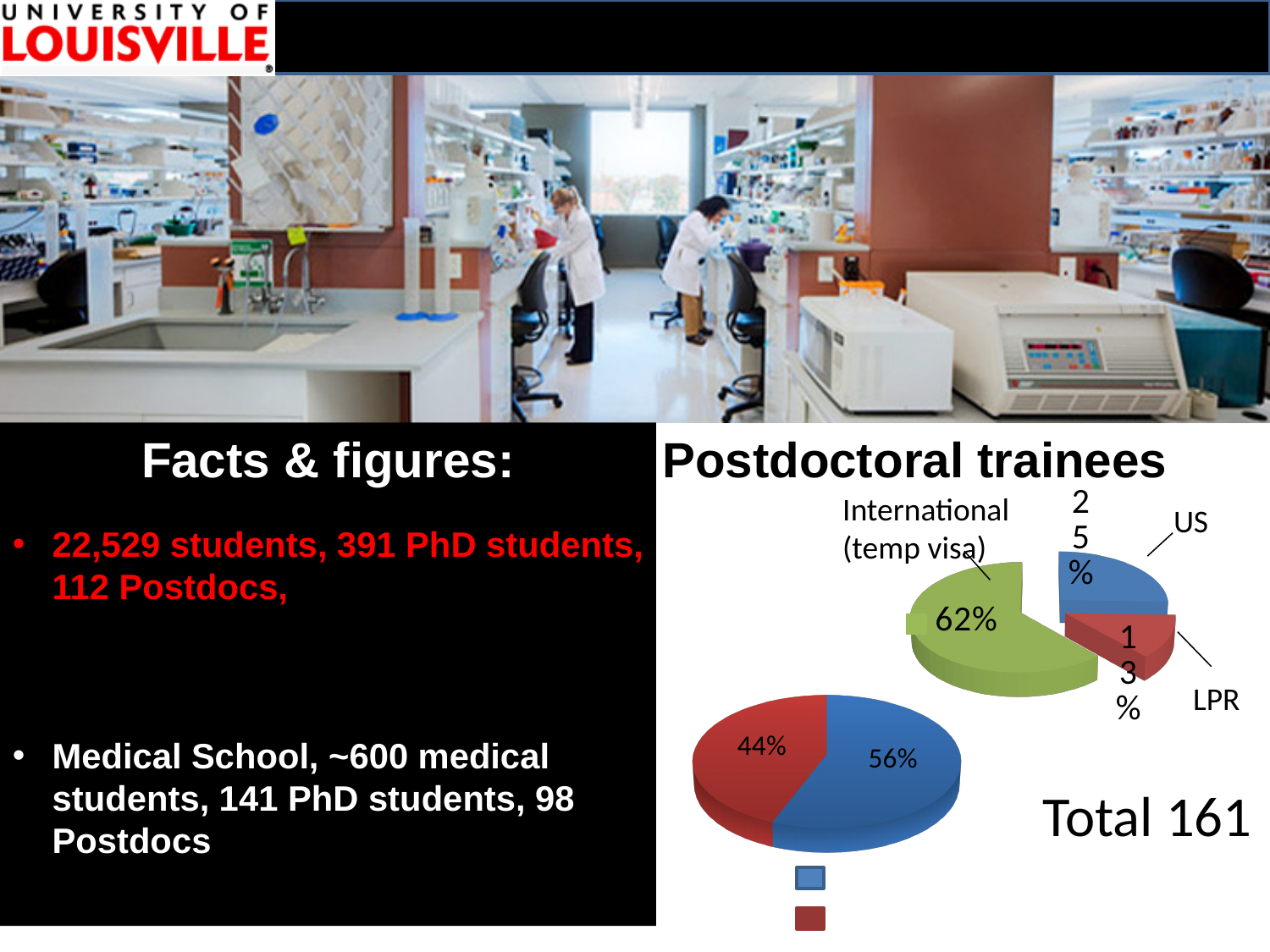
In the Postdoctoral trainees pie chart, which is larger, the US share or the LPR share? US In the Postdoctoral trainees pie chart, how many percentage points larger is the International (temp visa) share than the US share? 37 In the Postdoctoral trainees pie chart, which category has the smallest share? LPR In the lower pie chart on the right side of the slide, what percentage is shown on the blue slice? 56% What kind of chart is the Postdoctoral trainees chart? pie chart In the Postdoctoral trainees pie chart, what share of trainees are International (temp visa)? 62% In the Postdoctoral trainees pie chart, which category has the largest share? International (temp visa) In the lower pie chart on the right side of the slide, what percentage is shown on the red slice? 44% In the Postdoctoral trainees pie chart, what share of trainees are US? 25% How many slices does the Postdoctoral trainees pie chart have? 3 What kind of chart is the lower chart on the right side of the slide? pie chart In the Postdoctoral trainees pie chart, what share of trainees are LPR? 13%